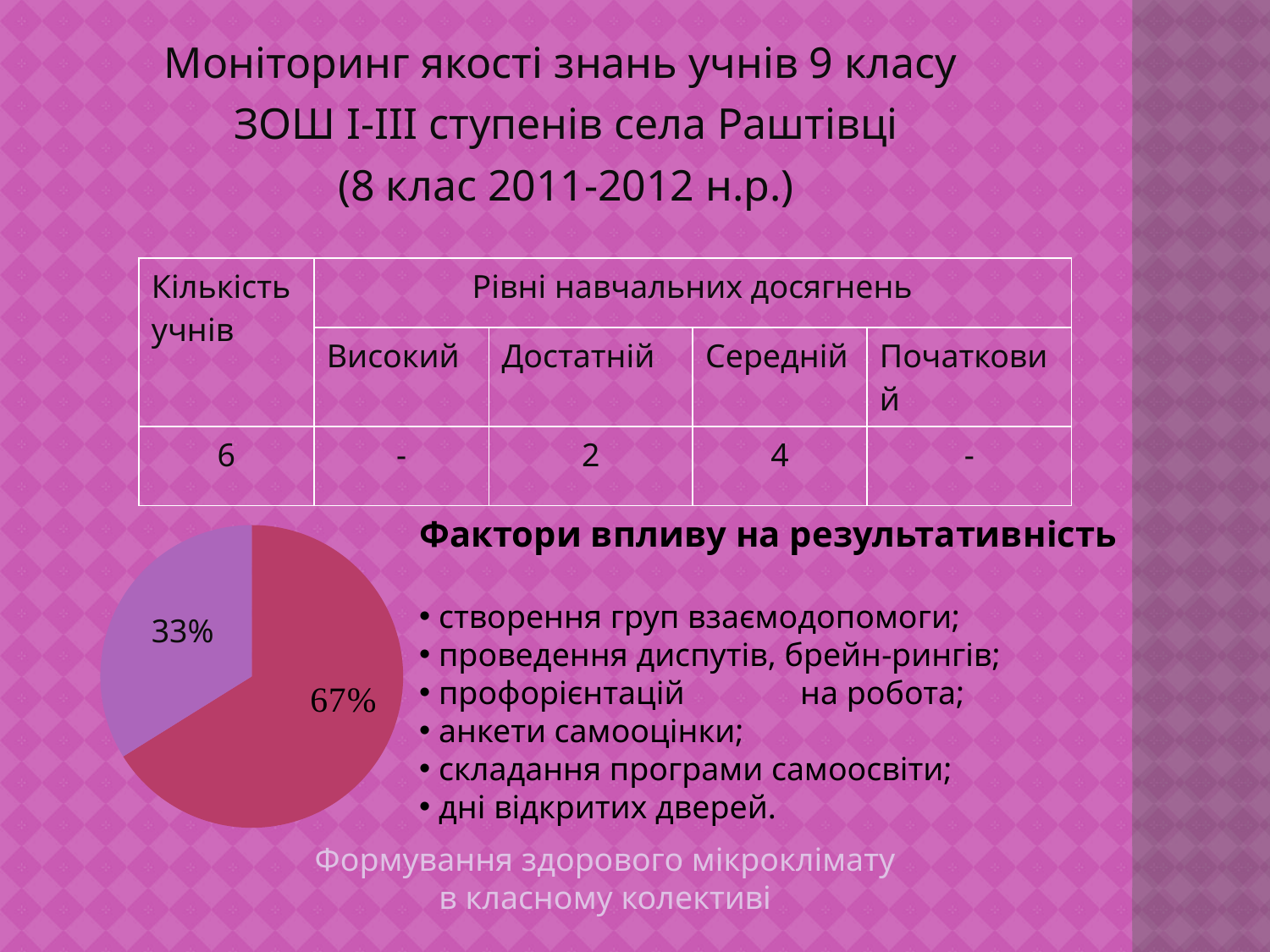
By how many percentage points does the larger slice of the pie chart exceed the smaller slice? 34 percentage points What do the two slice values of the pie chart add up to? 100% How many slices does the pie chart have? 2 What is the value shown on the red slice of the pie chart? 67% Which slice of the pie chart is larger, the red one or the purple one? the red one Does the pie chart have a legend? No What is the value of the largest slice of the pie chart? 67% What is the value shown on the purple slice of the pie chart? 33% What kind of chart is shown on the slide? pie chart What is the value of the smallest slice of the pie chart? 33%